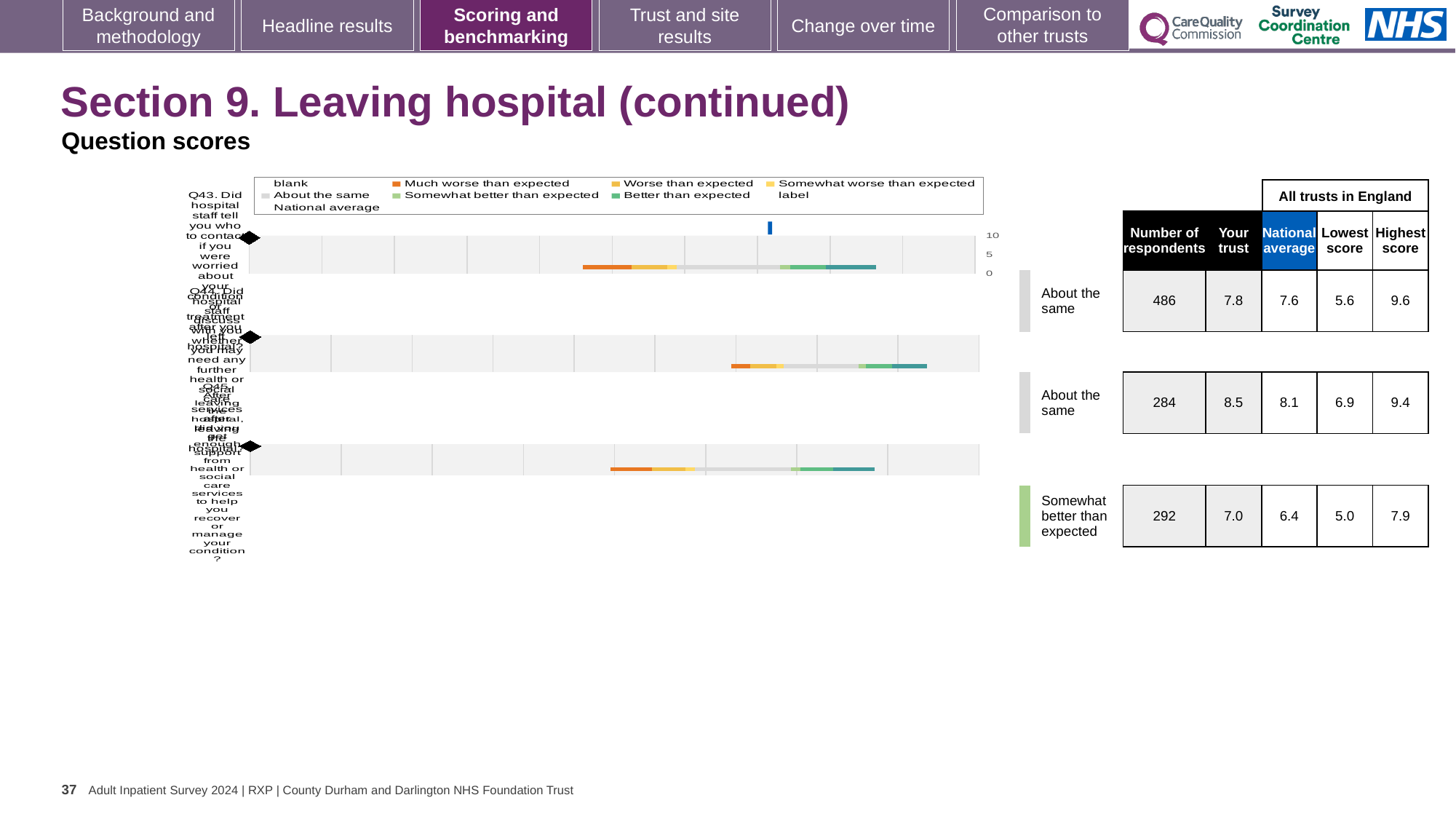
For Q43, what is the difference between the trust score and the national average? 0.2 How many questions (rows) are plotted in the chart? 3 What benchmark category is shown for the first row (Q43)? About the same Which question has the highest 'Your trust' score? Q44 How many respondents are shown for the third row (Q45)? 292 What kind of chart is used to show the question scores on this slide? bar chart What is the 'Your trust' score for the first row (Q43)? 7.8 What is the national average score for the second row (Q44)? 8.1 For Q44, what is the difference between the highest score and the lowest score across all trusts in England? 2.5 What benchmark category is shown for the third row (Q45)? Somewhat better than expected For Q45, is the trust score higher or lower than the national average? higher Which question has the lowest national average score? Q45